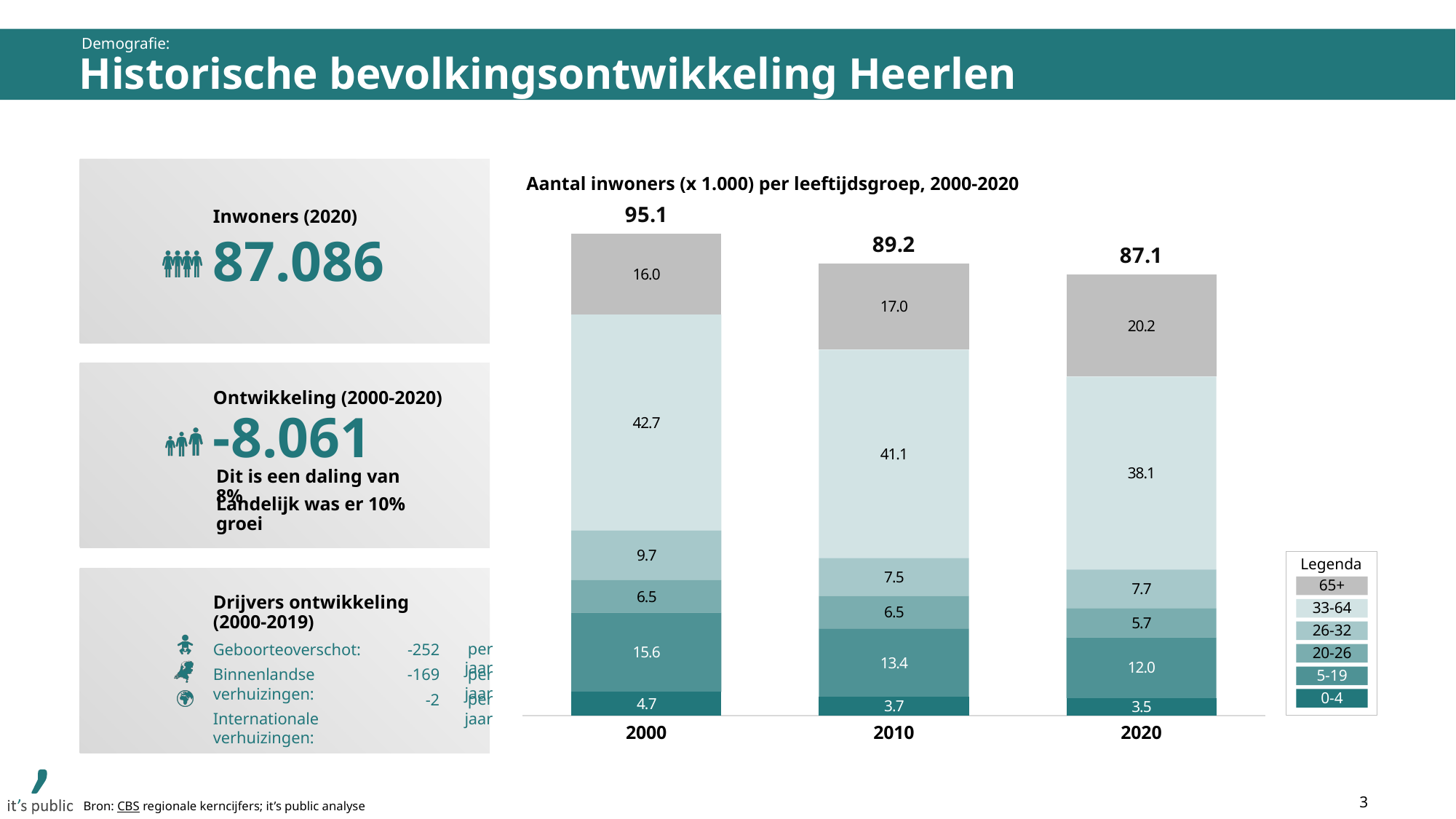
Which year has the lowest value for the 0-4 age group? 2020 What is the total of the stacked bar for 2010? 89.2 Which is larger: the 26-32 value in 2000 or the 26-32 value in 2020? 2000 Do the total values rise or fall from 2000 to 2020? Fall What is the value for the 65+ age group in 2020? 20.2 How many age groups does the legend list? 6 What kind of chart is shown? Stacked bar chart What is the difference between the 65+ values in 2020 and 2000? 4.2 What is the value for the 33-64 age group in 2010? 41.1 Which year has the highest total number of inhabitants? 2000 What is the value for the 5-19 age group in 2000? 15.6 How many years are shown on the x axis? 3